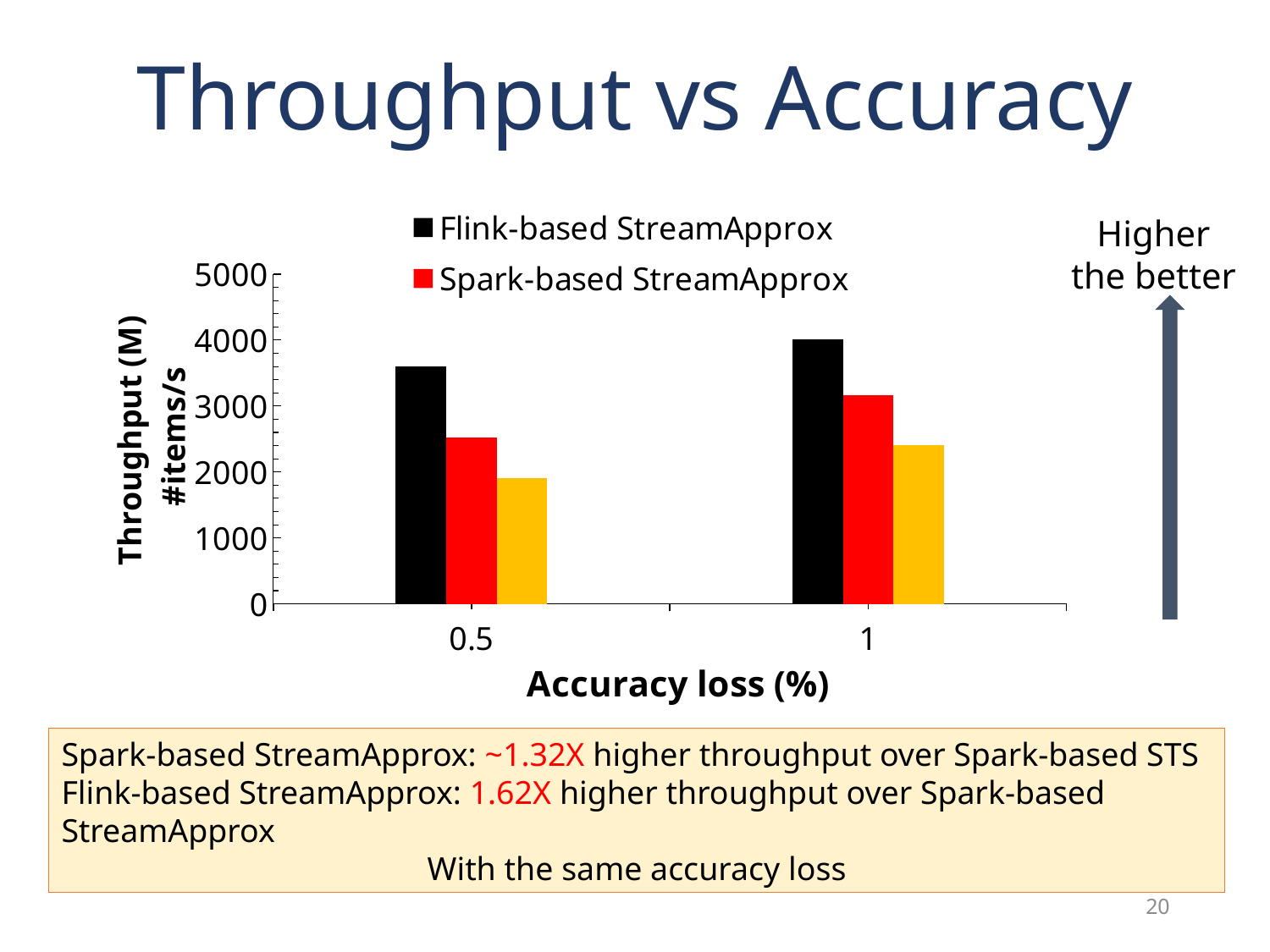
How many series does the chart legend list? 2 Is the throughput of Spark-based StreamApprox at 1% accuracy loss greater or less than 4000? less What colour are the bars for Flink-based StreamApprox? black What is the label of the y axis? Throughput (M) #items/s Which series has the highest throughput at 1% accuracy loss? Flink-based StreamApprox Is the throughput of Flink-based StreamApprox at 0.5% accuracy loss greater or less than 3000? greater Does the throughput of Spark-based StreamApprox rise or fall as accuracy loss goes from 0.5% to 1%? rise Is the throughput of Flink-based StreamApprox at 1% accuracy loss greater or less than 3000? greater What kind of chart is shown on the slide? bar chart How many accuracy loss categories are shown on the x axis? 2 At 0.5% accuracy loss, which has higher throughput: Flink-based StreamApprox or Spark-based StreamApprox? Flink-based StreamApprox